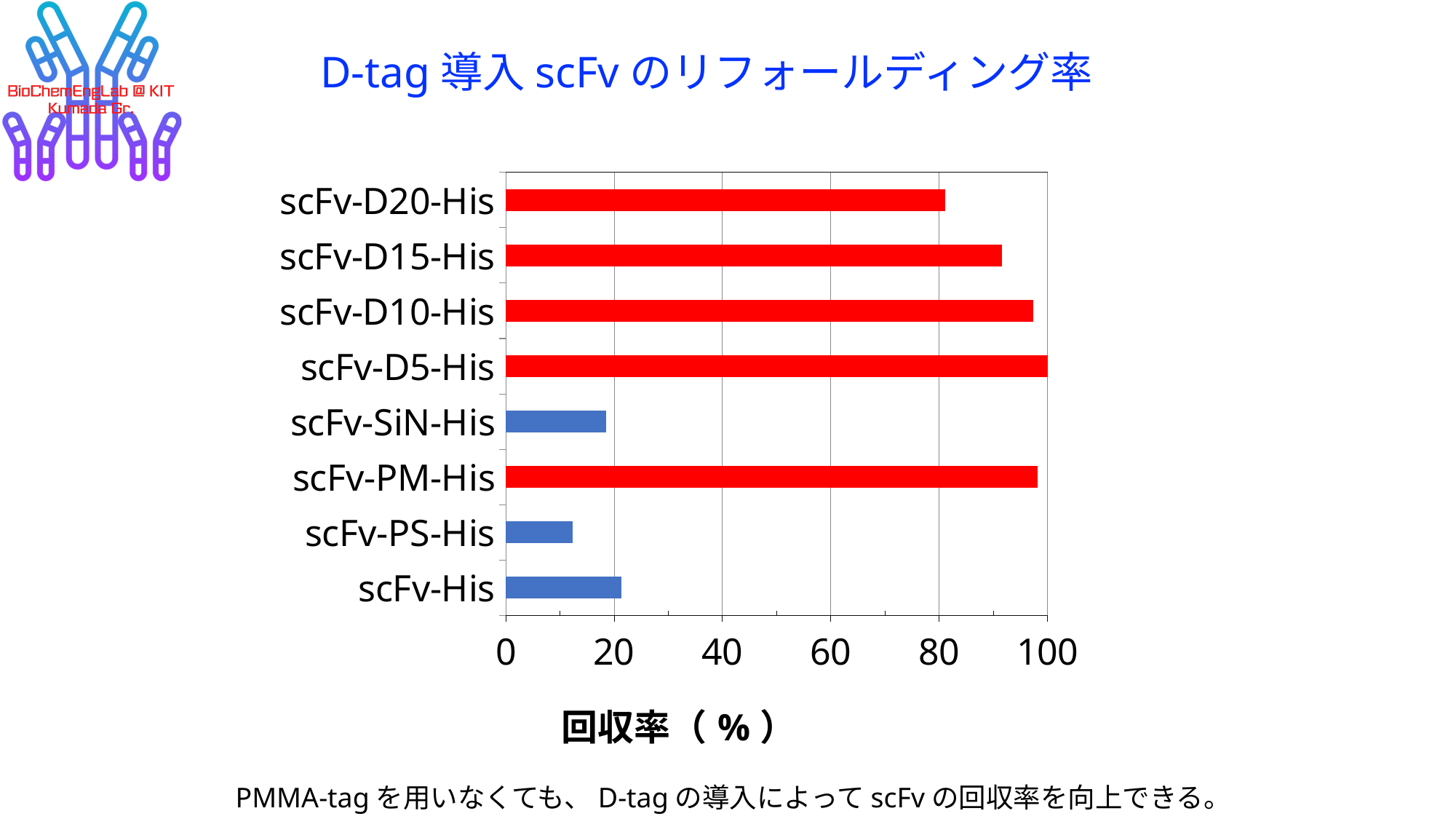
Which category has the lowest 回収率 in the chart? scFv-PS-His How many categories (scFv constructs) are plotted in the chart? 8 Which is larger, the value for scFv-D15-His or scFv-D20-His? scFv-D15-His Is the value for scFv-D15-His greater or less than 80? greater Is the value for scFv-PS-His greater or less than 20? less What kind of chart is shown on the slide? bar chart What is the label of the horizontal axis of the chart? 回収率（%） Which is larger, the value for scFv-His or scFv-PS-His? scFv-His Is the value for scFv-His greater or less than 40? less What colour are the bars for the D-tag constructs (scFv-D5-His to scFv-D20-His)? red